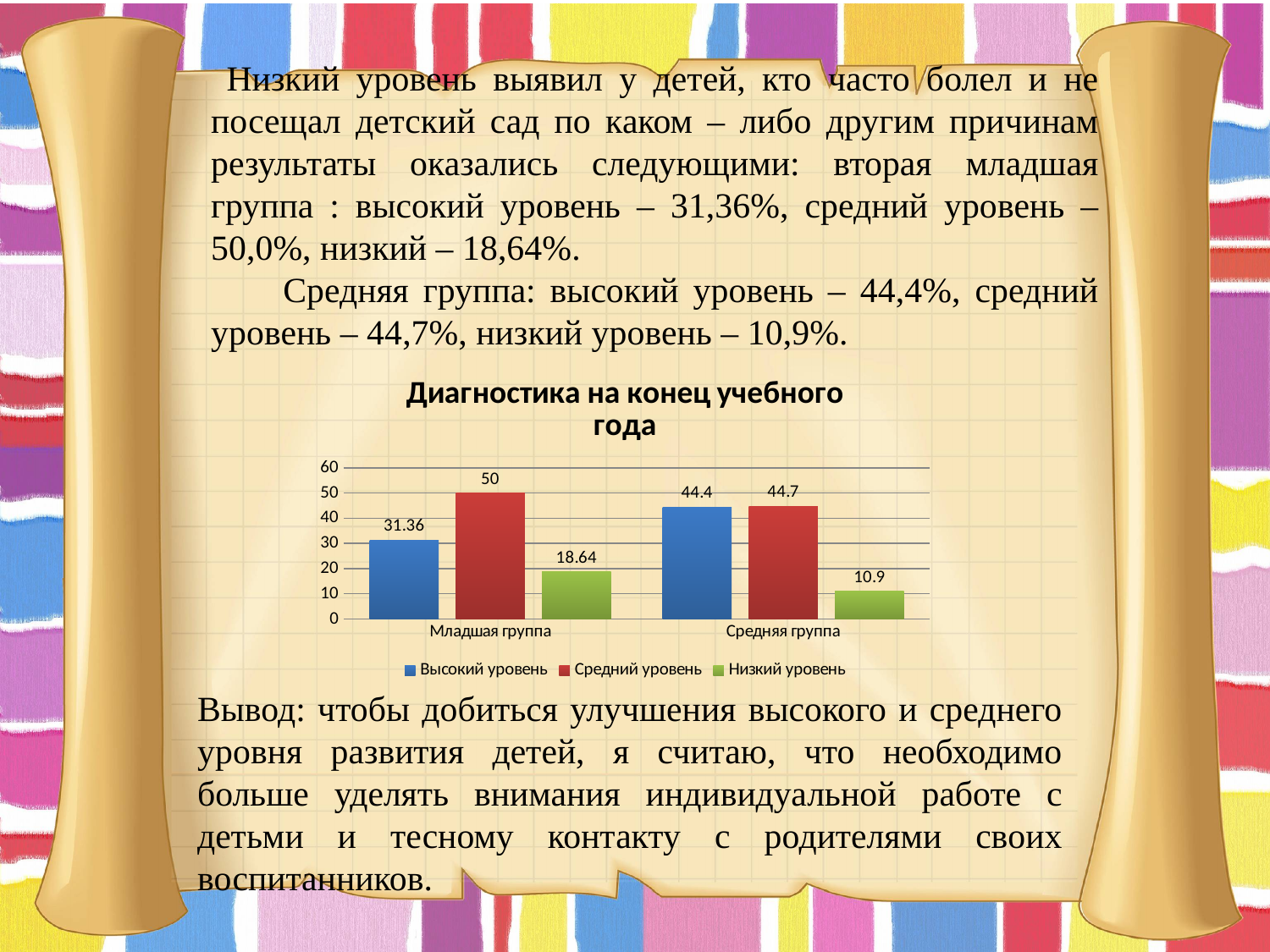
How many groups (categories) are shown on the x axis? 2 What is the value for Высокий уровень in Младшая группа? 31.36 How many series does the legend list? 3 What is the value for Средний уровень in Младшая группа? 50 What is the value for Низкий уровень in Средняя группа? 10.9 Is the value for Высокий уровень in Средняя группа greater or less than 40? greater What is the title of the chart? Диагностика на конец учебного года Which level has the highest value in Младшая группа? Средний уровень Which is larger: Низкий уровень in Младшая группа or Низкий уровень in Средняя группа? Младшая группа What type of chart is shown on the slide? bar chart What is the difference between Средний уровень and Низкий уровень in Младшая группа? 31.36 Which level has the lowest value in Средняя группа? Низкий уровень